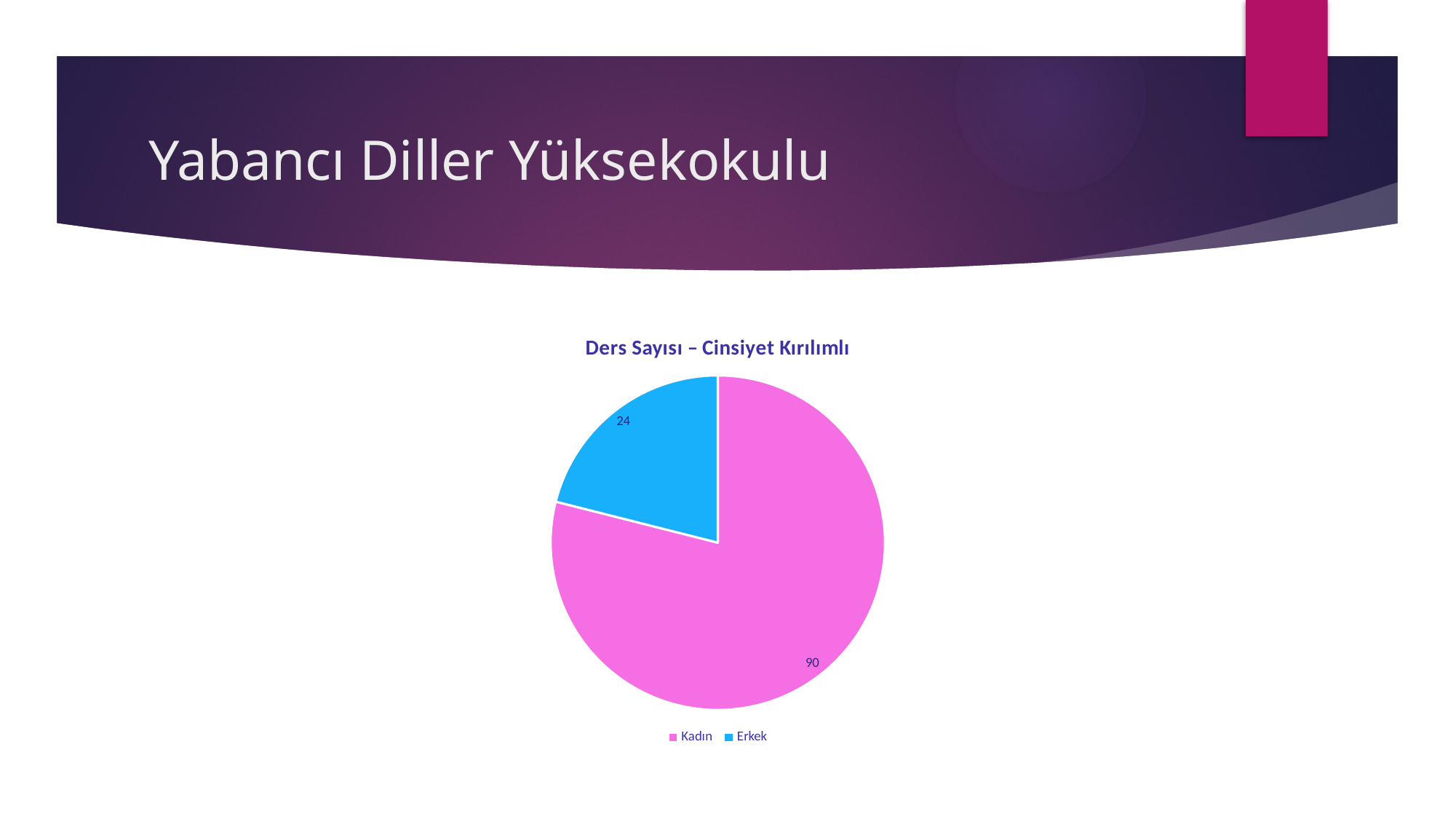
What kind of chart is shown on the slide? Pie chart What colour is the Erkek slice in the pie chart? Blue How many slices does the pie chart have? 2 How many entries does the legend list? 2 Which category has the smallest slice in the pie chart? Erkek Which category has the largest slice in the pie chart? Kadın What is the value for Erkek in the pie chart? 24 What is the title of the chart? Ders Sayısı – Cinsiyet Kırılımlı What is the value for Kadın in the pie chart? 90 What is the difference between the Kadın and Erkek values? 66 Which is larger, the value for Kadın or the value for Erkek? Kadın What is the total of all slices in the pie chart? 114